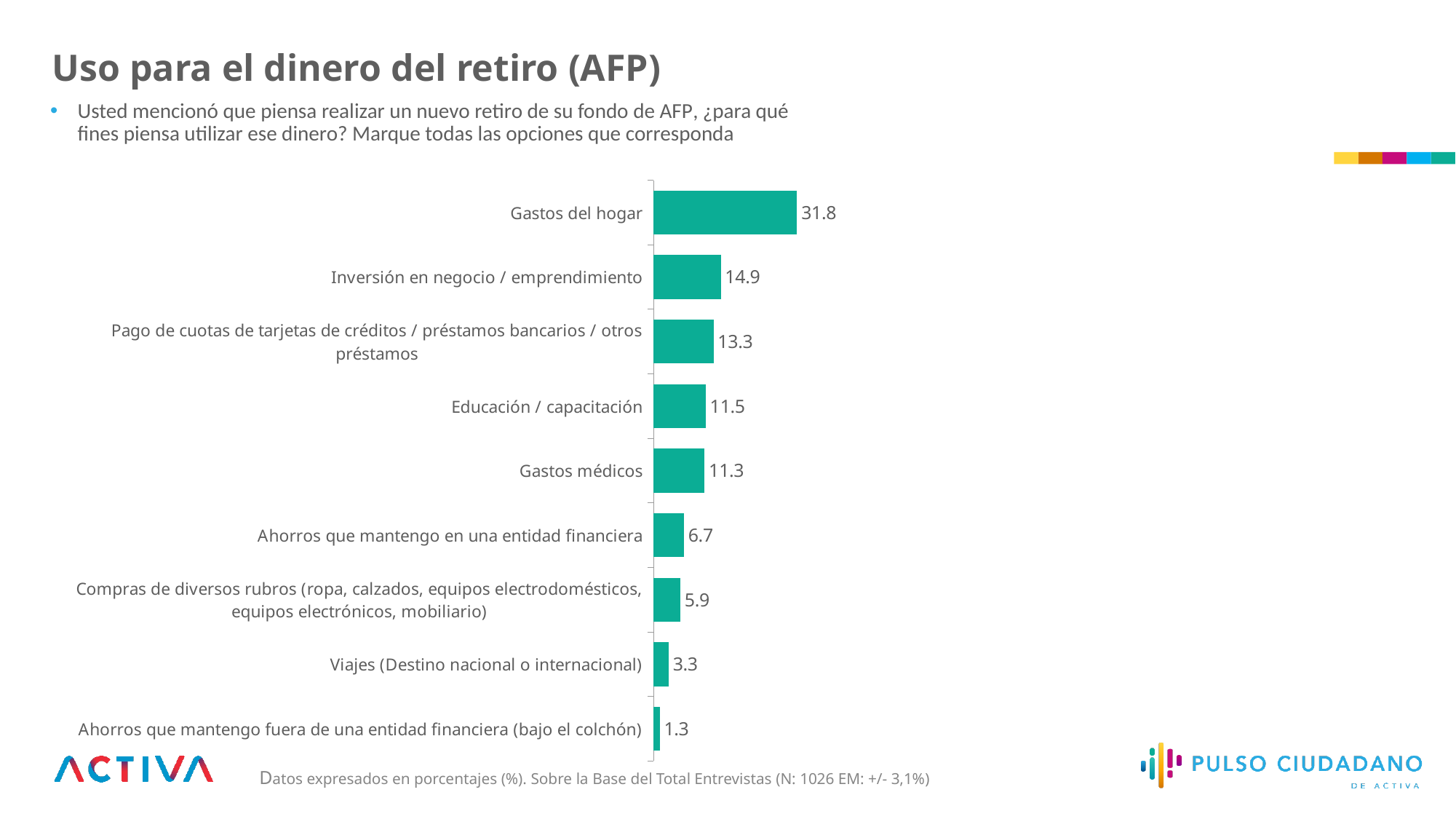
Which category has the lowest value? Ahorros que mantengo fuera de una entidad financiera (bajo el colchón) What is the difference between the values for Ahorros que mantengo en una entidad financiera and Viajes (Destino nacional o internacional)? 3.4 What kind of chart is shown on the slide? Bar chart Do the values rise or fall going from the top bar to the bottom bar? Fall What is the difference between the values for Gastos del hogar and Inversión en negocio / emprendimiento? 16.9 What is the value for Gastos del hogar? 31.8 Which category has the highest value? Gastos del hogar Which is larger: the value for Inversión en negocio / emprendimiento or the value for Pago de cuotas de tarjetas de créditos / préstamos bancarios / otros préstamos? Inversión en negocio / emprendimiento What is the value for Viajes (Destino nacional o internacional)? 3.3 How many categories are shown in the chart? 9 What is the title of the slide? Uso para el dinero del retiro (AFP) What is the value for Educación / capacitación? 11.5